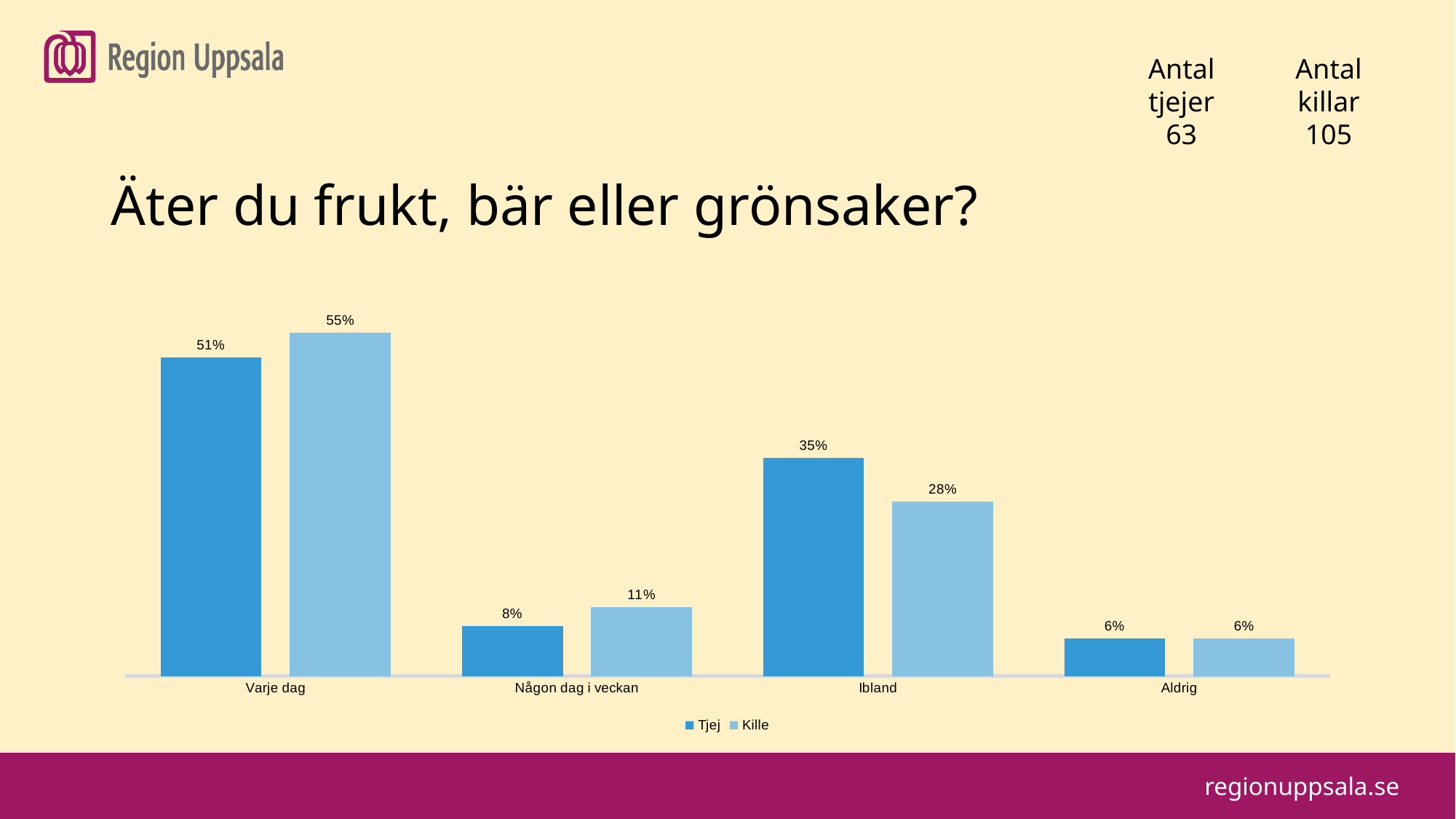
What is the value for Kille in the Någon dag i veckan category? 11% What is the value for Tjej in the Varje dag category? 51% What is the value for Kille in the Ibland category? 28% What kind of chart is shown on the slide? Bar chart What are the two series named in the legend? Tjej and Kille How many categories are shown on the x axis? 4 Which is larger in the Varje dag category, the Tjej value or the Kille value? Kille What is the difference between the Tjej and Kille values in the Ibland category? 7% Which category has the highest value for the Kille series? Varje dag How many series does the legend list? 2 Which category has the lowest value for the Tjej series? Aldrig What is the difference between the Kille values for Varje dag and Ibland? 27%